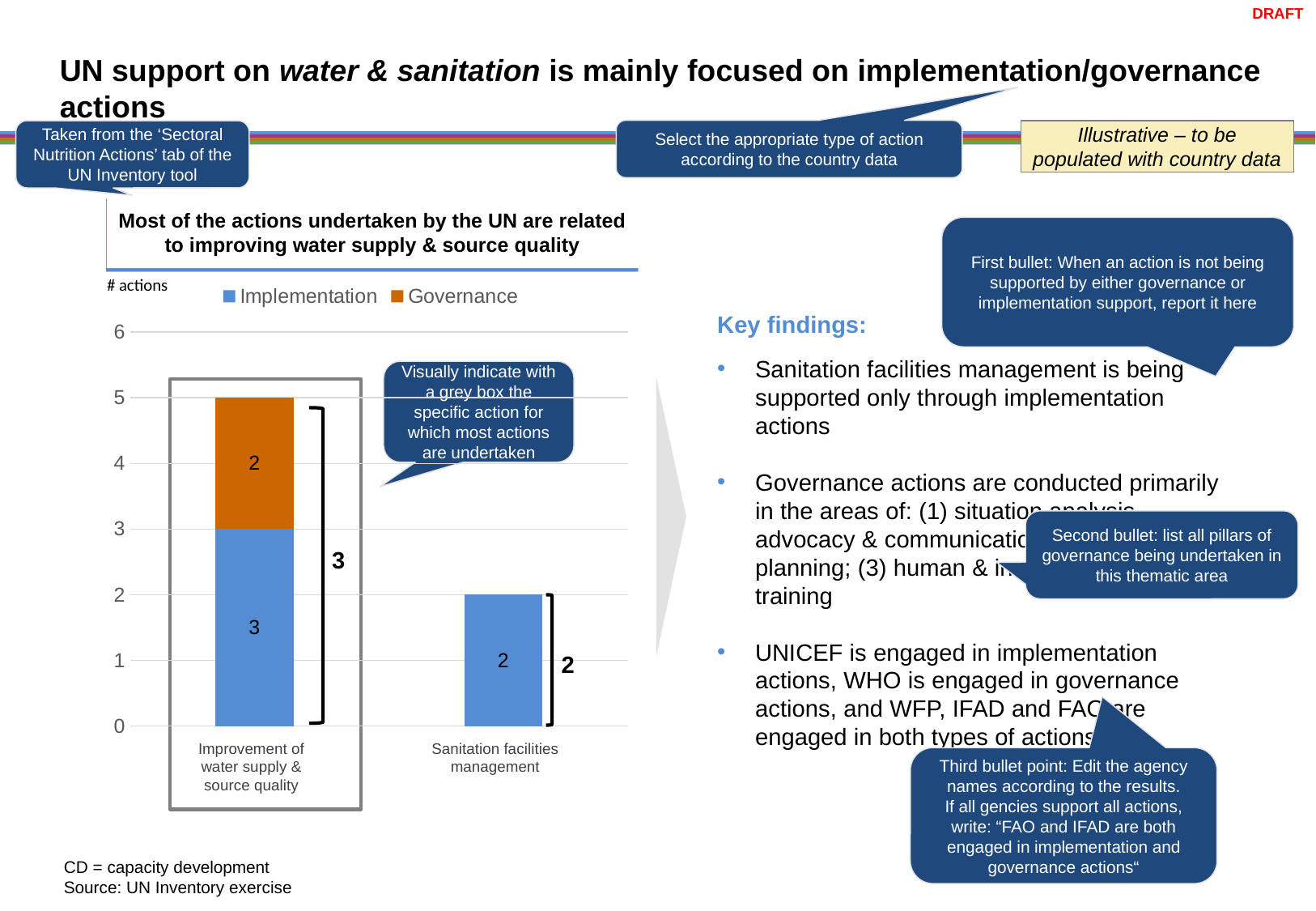
How many series does the chart legend list? 2 What is the Governance value for 'Improvement of water supply & source quality'? 2 What type of chart is shown on the slide? Stacked bar chart How many categories are shown on the x axis of the chart? 2 What is the difference between the Implementation values for 'Improvement of water supply & source quality' and 'Sanitation facilities management'? 1 Which is larger: the Implementation value or the Governance value for 'Improvement of water supply & source quality'? Implementation What are the two series named in the chart legend? Implementation and Governance What is the total of the stacked bar for 'Improvement of water supply & source quality'? 5 What is the label shown on the y axis of the chart? # actions What is the Implementation value for 'Improvement of water supply & source quality'? 3 What is the Implementation value for 'Sanitation facilities management'? 2 Which category has the taller stacked bar? Improvement of water supply & source quality